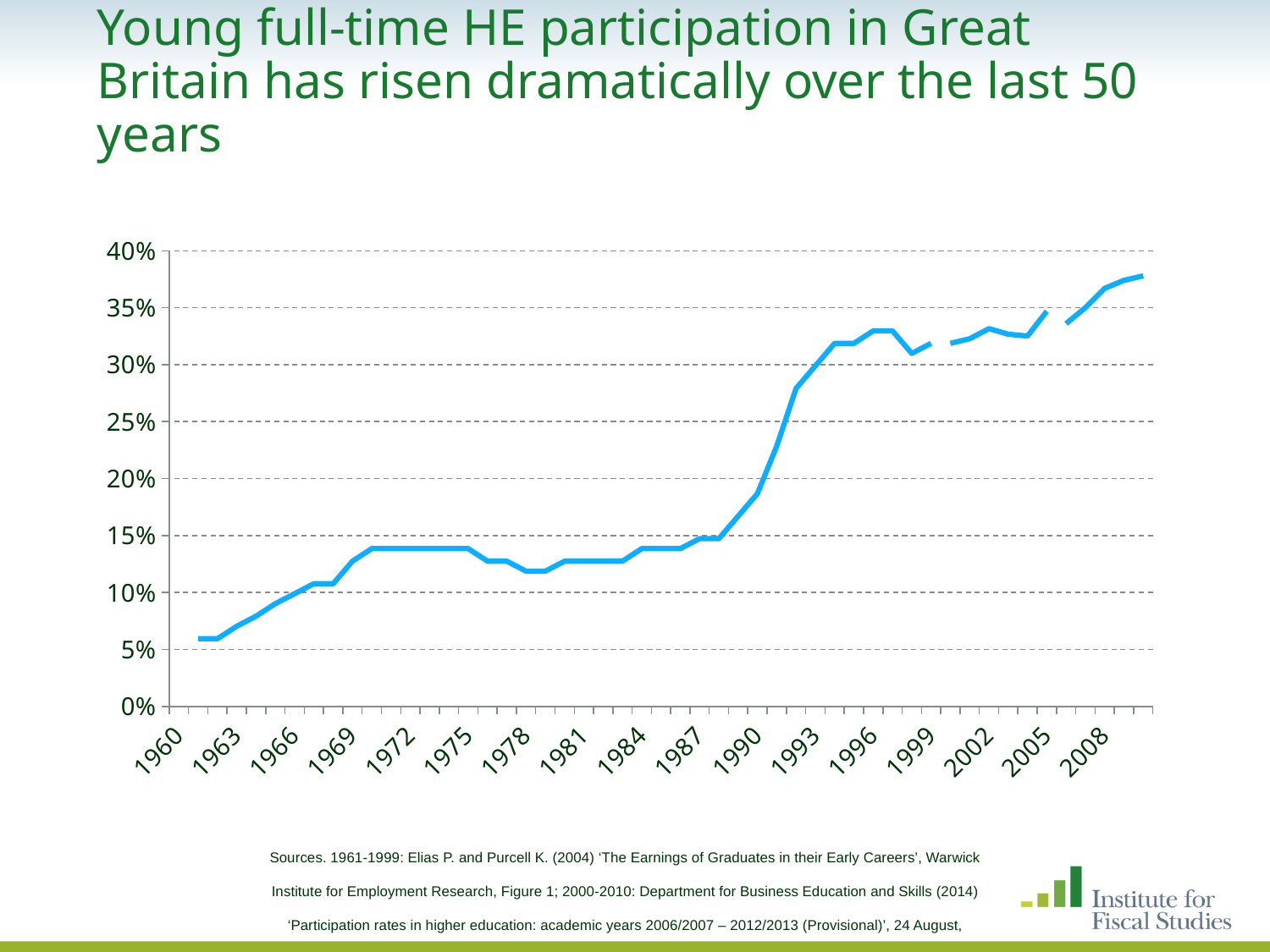
Overall, do the values rise or fall from 1960 to 2008? rise Which year has the larger value, 1987 or 1993? 1993 Is the value for 1993 greater or less than 25%? greater Is the value for 1978 greater or less than 15%? less What kind of chart is shown on the slide? line chart Is the value for 1963 greater or less than 10%? less Which year has the larger value, 1963 or 1969? 1969 What is the title of the slide? Young full-time HE participation in Great Britain has risen dramatically over the last 50 years